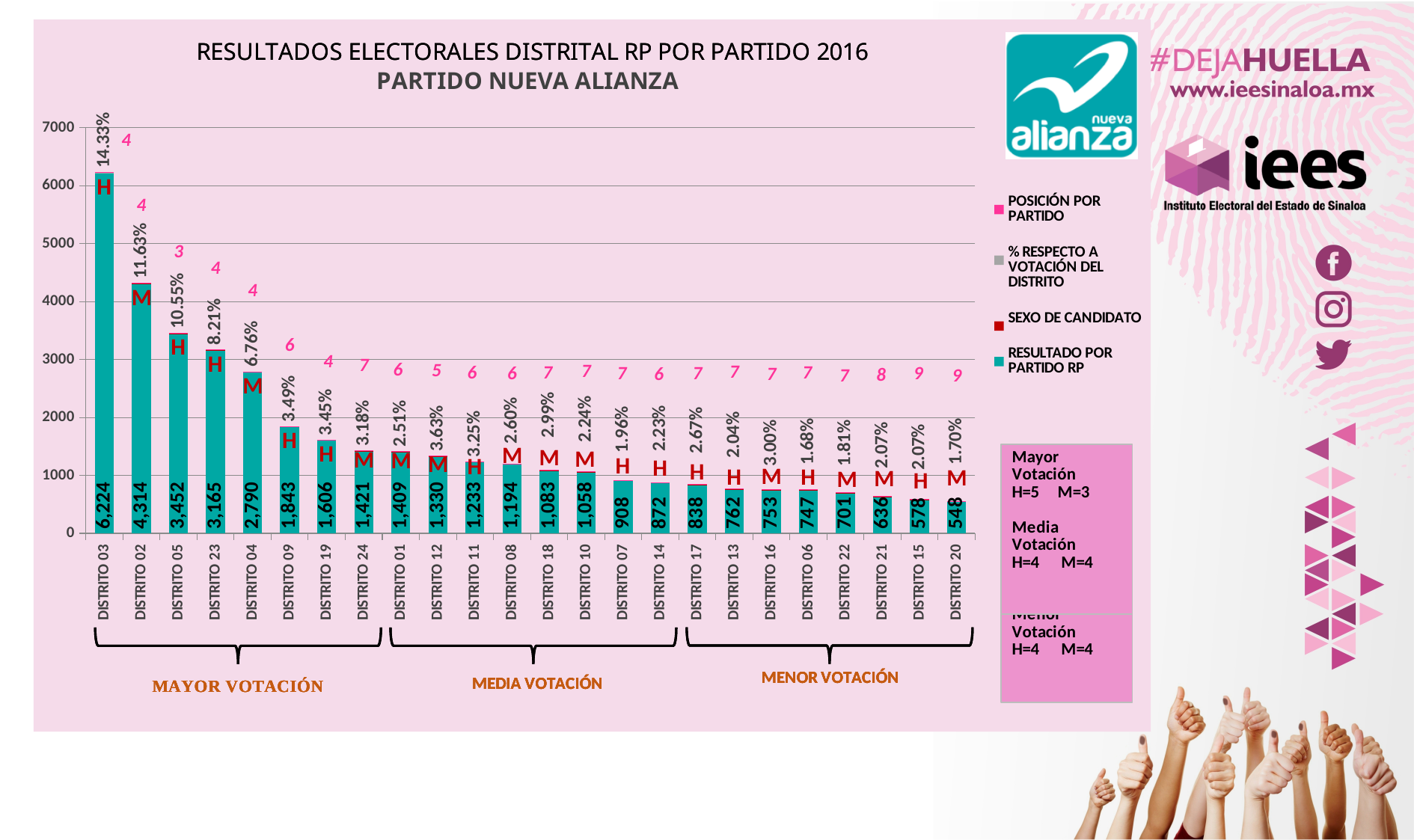
Which has a larger RP result, DISTRITO 05 or DISTRITO 23? DISTRITO 05 Is the RP result for DISTRITO 04 greater or less than 3000? less Which district has the lowest RP result? DISTRITO 20 What kind of chart is shown on the slide? bar chart Which district has the highest RP result? DISTRITO 03 What percentage of the district vote is shown for DISTRITO 02? 11.63% Do the RP result values rise or fall from left to right along the x axis? fall How many entries does the chart legend list? 4 How many districts are shown on the x axis of the chart? 24 What is the difference between the RP results of DISTRITO 03 and DISTRITO 02? 1,910 What is the RP result value for DISTRITO 20? 548 What is the RP result value for DISTRITO 03? 6,224